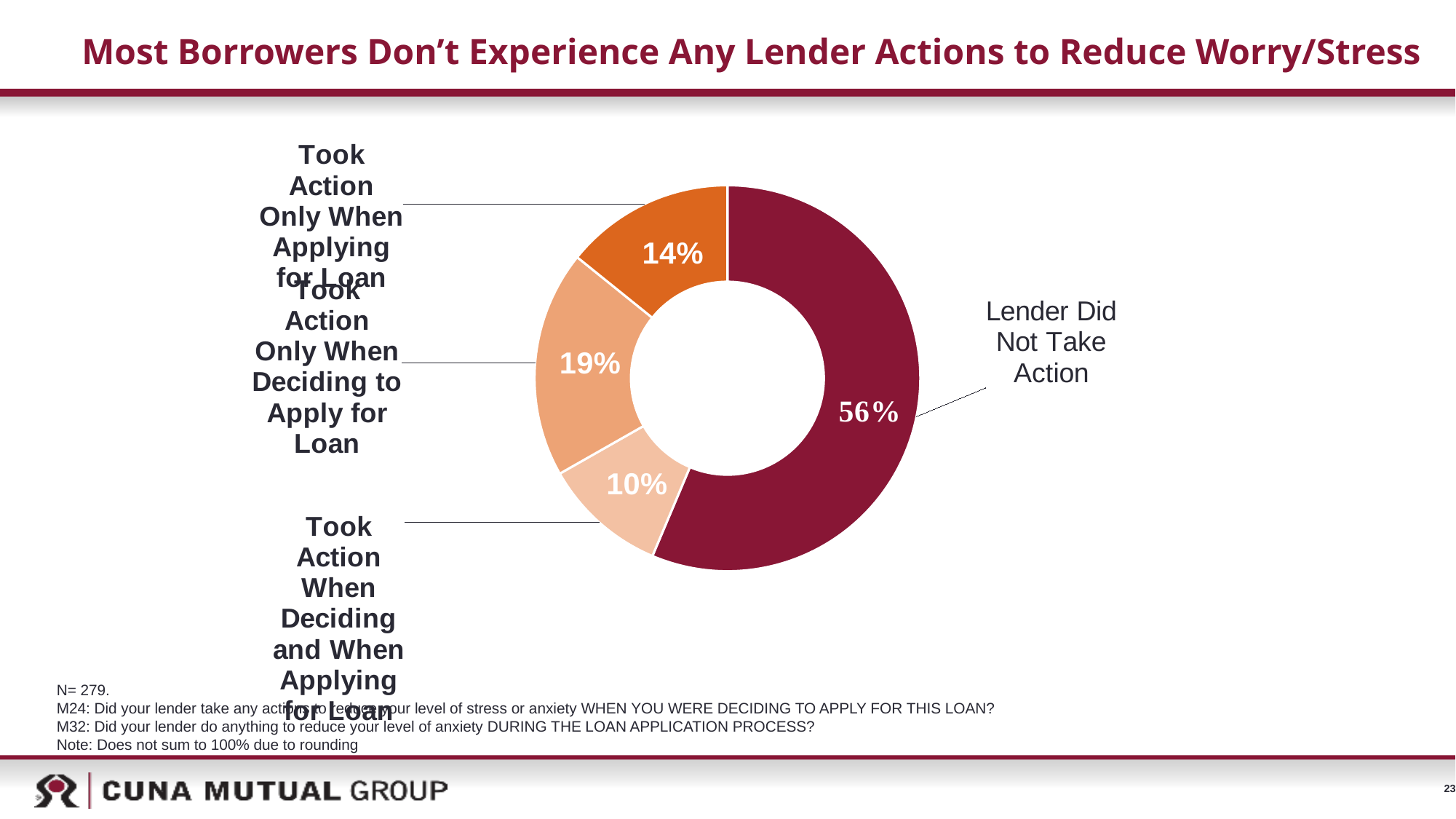
What type of chart is shown on the slide? Donut (pie) chart What is the difference in percentage points between 'Lender Did Not Take Action' and 'Took Action Only When Deciding to Apply for Loan'? 37 percentage points What percentage of borrowers said the lender took action only when deciding to apply for the loan? 19% Which category has the largest share of the chart? Lender Did Not Take Action Which is larger: the share for 'Took Action Only When Applying for Loan' or 'Took Action Only When Deciding to Apply for Loan'? Took Action Only When Deciding to Apply for Loan Which category has the smallest share of the chart? Took Action When Deciding and When Applying for Loan What is the sample size (N) noted on the slide? 279 What percentage of borrowers said the lender took action both when deciding and when applying for the loan? 10% How many categories are shown in the chart? 4 What share of borrowers said the lender did not take action? 56% What is the title of the slide? Most Borrowers Don't Experience Any Lender Actions to Reduce Worry/Stress What percentage of borrowers said the lender took action only when applying for the loan? 14%